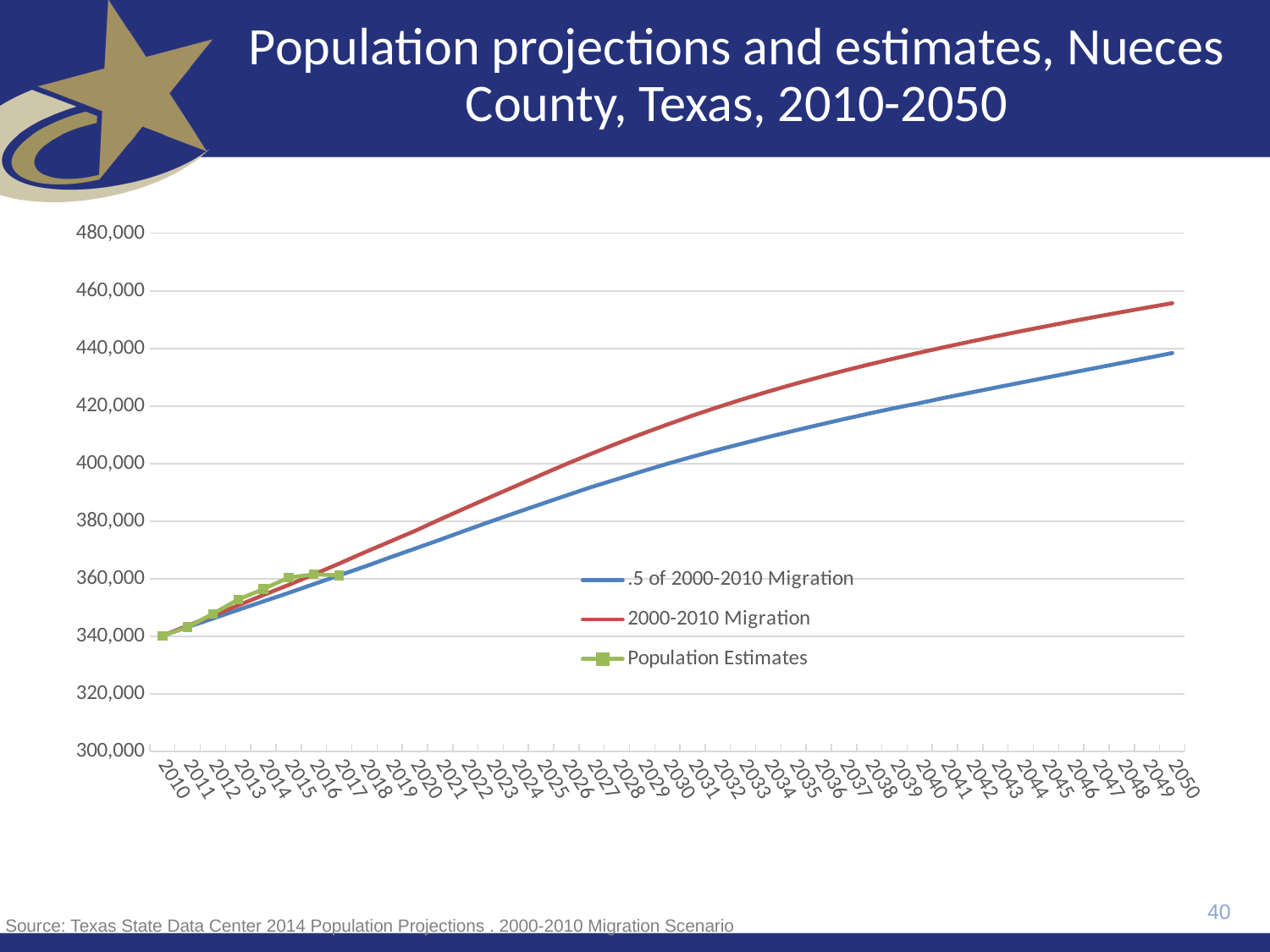
In 2050, which series is higher: 2000-2010 Migration or .5 of 2000-2010 Migration? 2000-2010 Migration Is the value for 2000-2010 Migration in 2030 greater or less than 400,000? greater Is the value for 2000-2010 Migration in 2050 greater or less than 440,000? greater Do the values for 2000-2010 Migration rise or fall from 2010 to 2050? Rise Which series reaches the highest value in 2050? 2000-2010 Migration Is the value for Population Estimates in 2016 greater or less than 380,000? less What kind of chart is shown on the slide? Line chart How many years are labelled along the x axis? 41 How many series does the legend list? 3 What is the title of the chart? Population projections and estimates, Nueces County, Texas, 2010-2050 Which series is drawn with square markers? Population Estimates